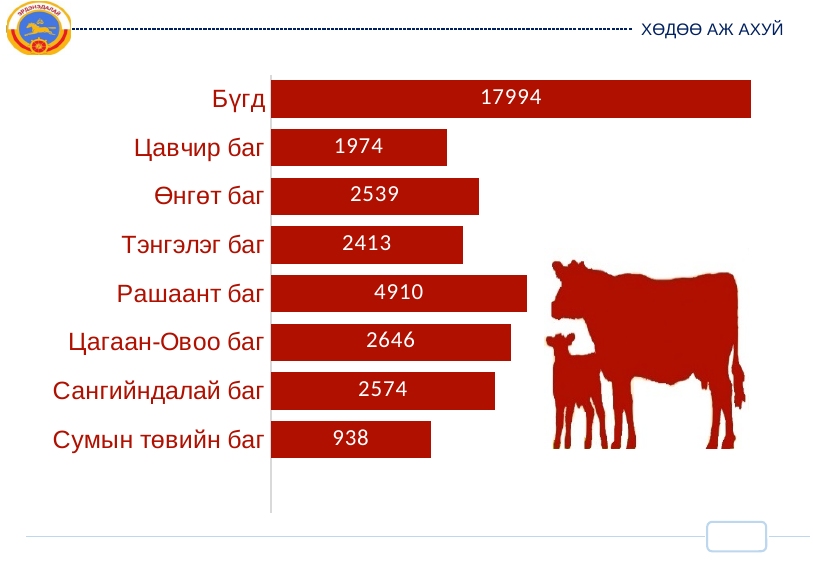
Which category has the highest value? Бүгд Which category has the lowest value? Сумын төвийн баг How many categories are shown in the chart? 8 Excluding Бүгд, which баг has the highest value? Рашаант баг What is the value for Бүгд? 17994 Which is larger, the value for Өнгөт баг or the value for Сангийндалай баг? Сангийндалай баг What is the value for Рашаант баг? 4910 What kind of chart is shown on the slide? Bar chart What is the difference between the values for Рашаант баг and Цавчир баг? 2936 What is the value for Цагаан-Овоо баг? 2646 What is the value for Тэнгэлэг баг? 2413 What is the value for Сумын төвийн баг? 938